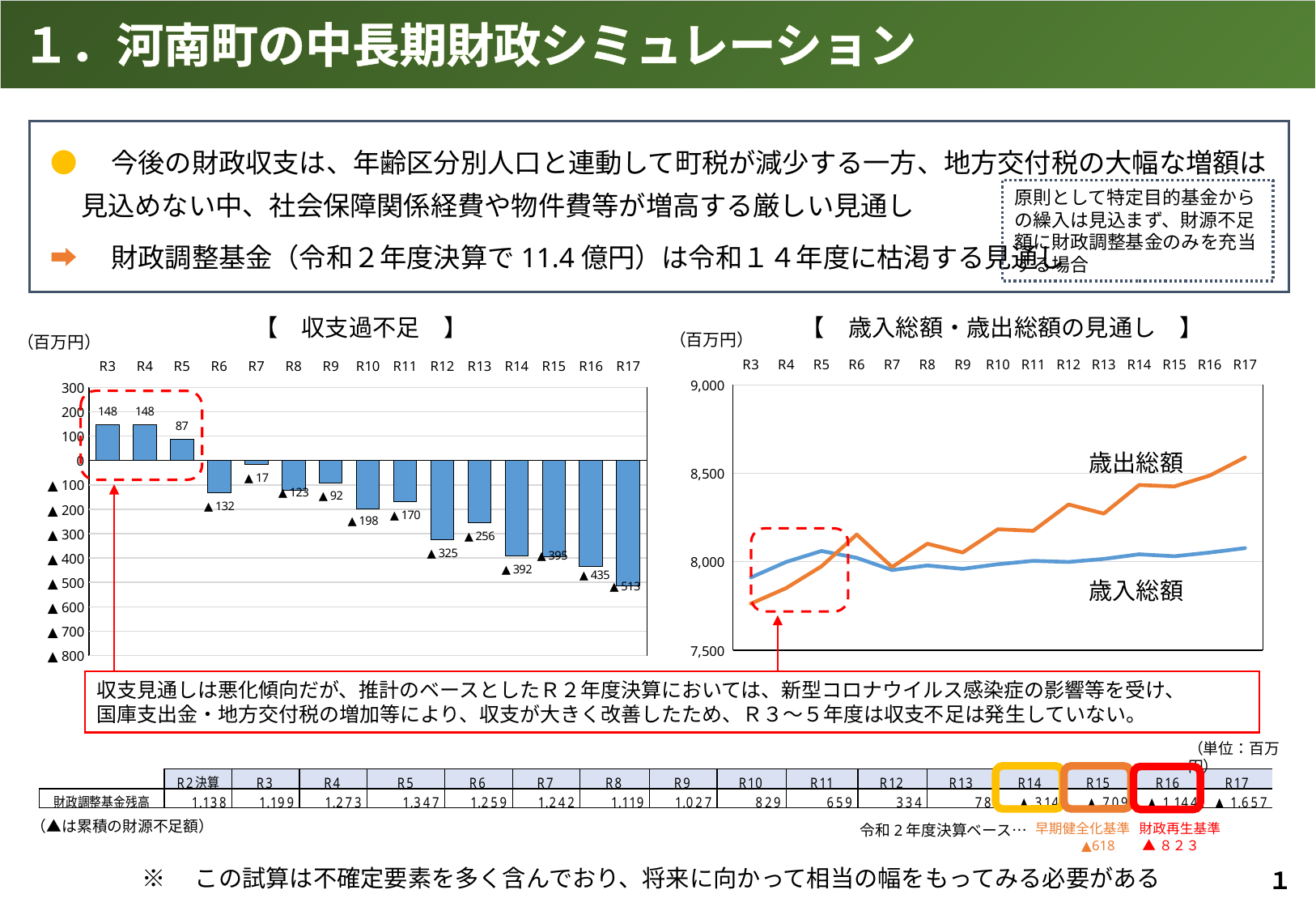
What kind of chart is the 歳入総額・歳出総額の見通し chart? Line chart In the 収支過不足 chart, do the values generally rise or fall from R6 to R17? Fall How many years are plotted in the 収支過不足 chart? 15 What kind of chart is the 収支過不足 chart? Bar chart In the 収支過不足 chart, what is the value for R5? 87 In the 収支過不足 chart, which is larger in magnitude, the deficit for R13 or the deficit for R11? R13 In the 収支過不足 chart, which year has the lowest (most negative) value? R17 In the 収支過不足 chart, what is the value for R17? ▲513 In the 収支過不足 chart, what is the value for R10? ▲198 In the 歳入総額・歳出総額の見通し chart, is the 歳出総額 value for R3 greater or less than 8,000? less In the 歳入総額・歳出総額の見通し chart, is the 歳出総額 value for R17 greater or less than 8,500? greater In the 収支過不足 chart, what is the difference between the R3 value (148) and the R5 value (87)? 61